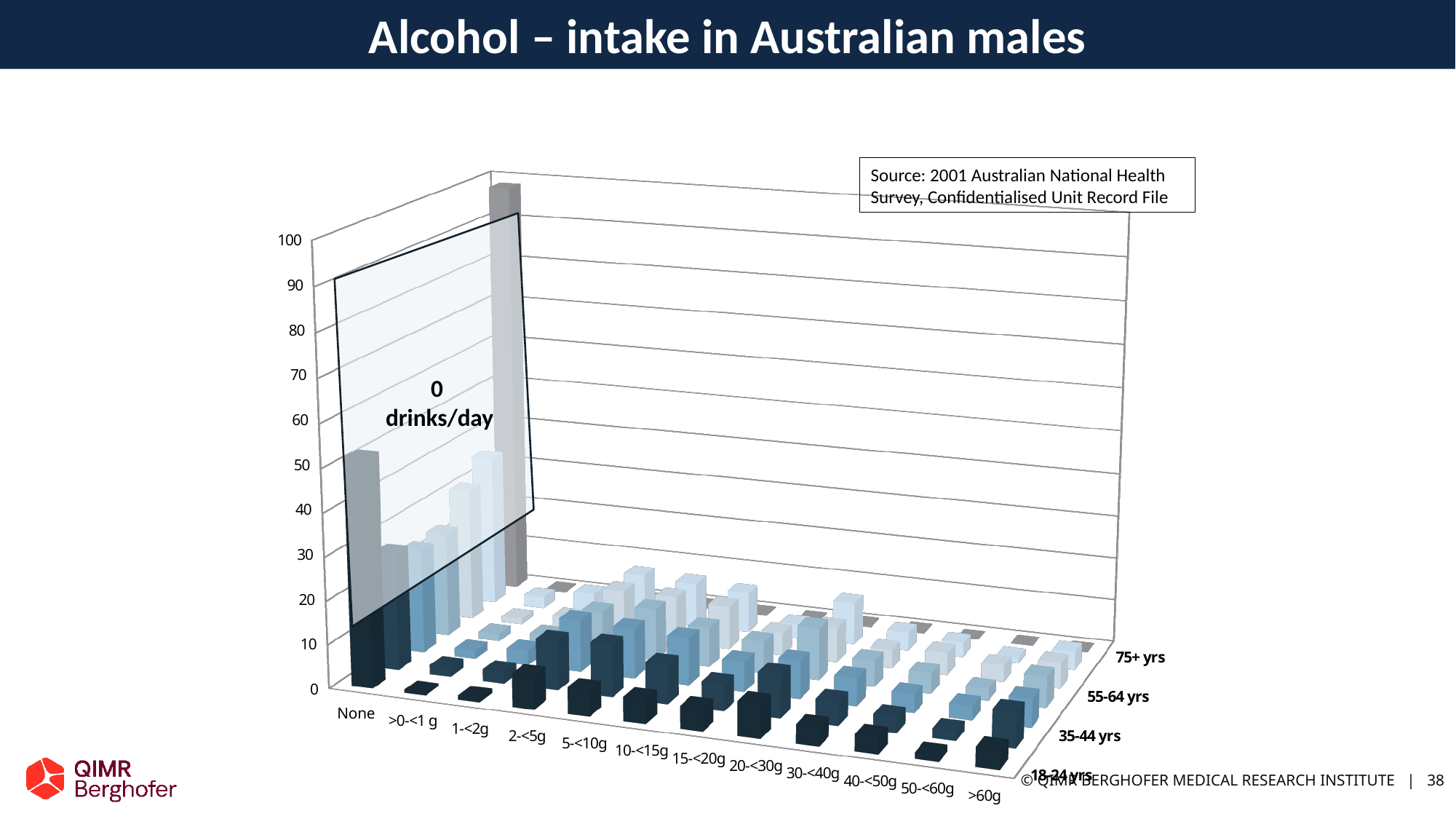
What kind of chart is shown on the slide? Bar chart For the 75+ yrs series, which is larger: the bar for None or the bar for >60g? None How many age-group series are plotted in the chart? 7 For the 75+ yrs series, which intake category has the highest bar? None Is the value for None in the 18-24 yrs series greater or less than 10? greater Which intake category is labelled first (leftmost) on the x axis? None What is the highest value shown on the vertical axis? 100 How many alcohol intake categories are shown along the x axis? 12 For the 18-24 yrs series, which is larger: the bar for None or the bar for >0-<1 g? None What is the title of the slide's chart? Alcohol – intake in Australian males